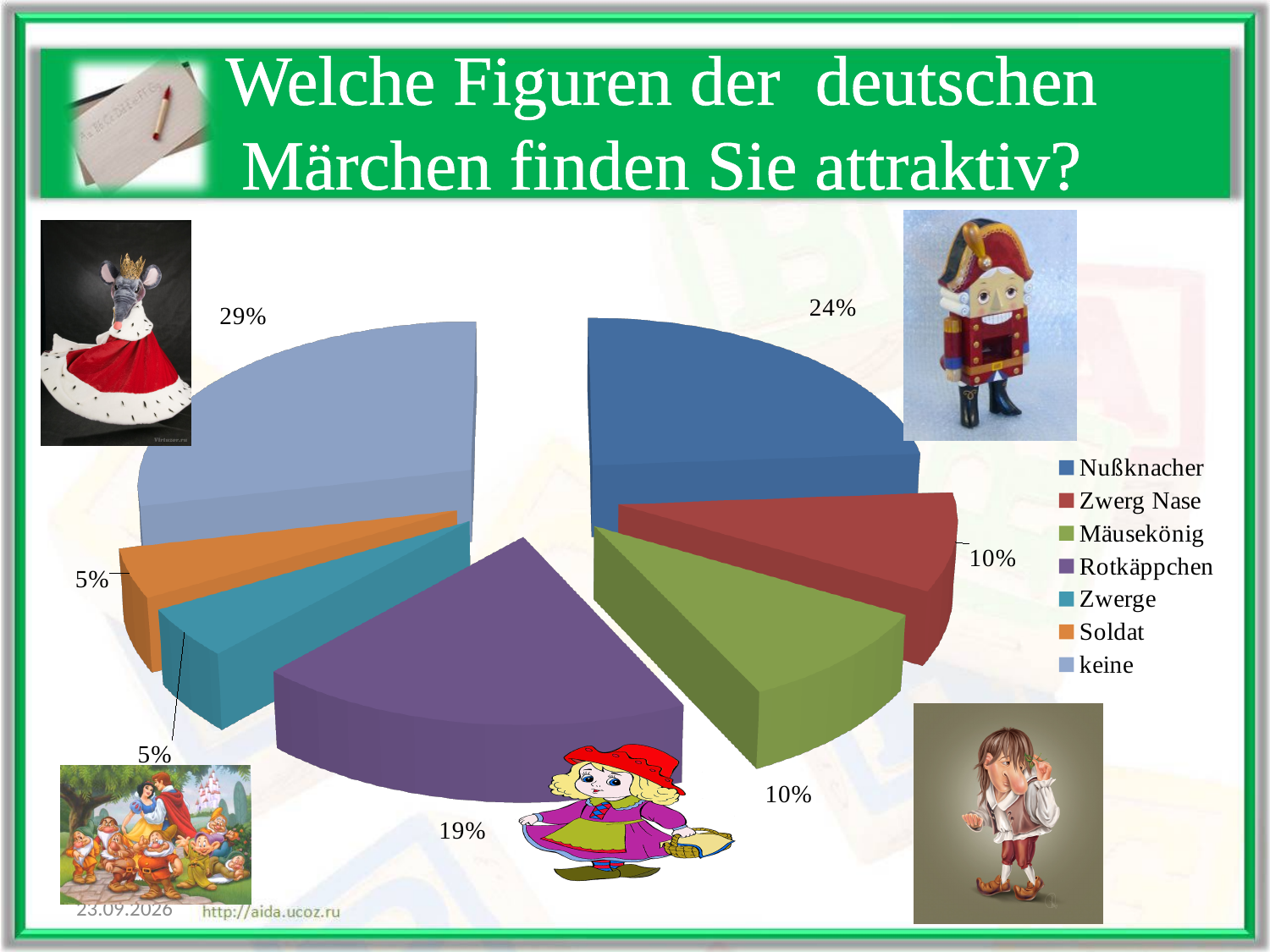
Which is larger, the share for Rotkäppchen or the share for Mäusekönig? Rotkäppchen What type of chart is shown on the slide? pie chart What percentage is shown for keine? 29% How many slices does the pie chart have? 7 What percentage is shown for Rotkäppchen? 19% Which category has the largest share of the pie? keine What is the difference in percentage points between keine and Nußknacher? 5 What percentage of the pie is labelled for Nußknacher? 24% What percentage is shown for Zwerg Nase? 10% What colour is the slice for Rotkäppchen? purple How many categories does the legend list? 7 What percentage is shown for Soldat? 5%